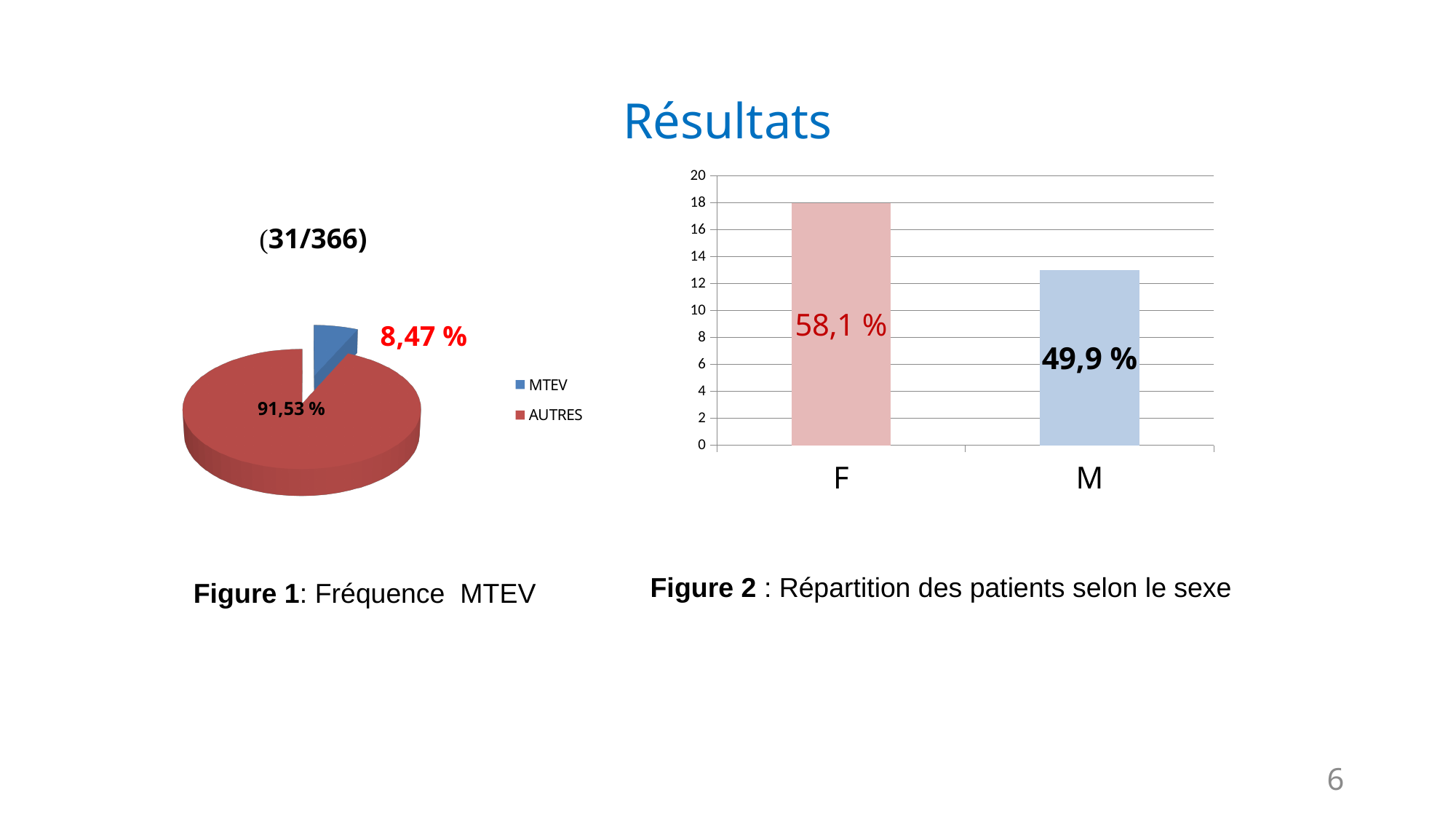
In Figure 1 (Fréquence MTEV), how many slices does the pie have? 2 In Figure 2 (Répartition des patients selon le sexe), is the bar for M greater or less than 14 on the y axis? less In Figure 1 (Fréquence MTEV), what text is shown as the chart title above the pie? (31/366) In Figure 1 (Fréquence MTEV), what share of the pie is MTEV? 8,47 % In Figure 2 (Répartition des patients selon le sexe), what percentage label is printed on the M bar? 49,9 % In Figure 2 (Répartition des patients selon le sexe), which category has the tallest bar? F In Figure 1 (Fréquence MTEV), which slice is larger, MTEV or AUTRES? AUTRES What kind of chart is Figure 1 (Fréquence MTEV)? pie chart What kind of chart is Figure 2 (Répartition des patients selon le sexe)? bar chart In Figure 1 (Fréquence MTEV), what share of the pie is AUTRES? 91,53 % In Figure 2 (Répartition des patients selon le sexe), what percentage label is printed on the F bar? 58,1 % In Figure 2 (Répartition des patients selon le sexe), how many categories are shown on the x axis? 2